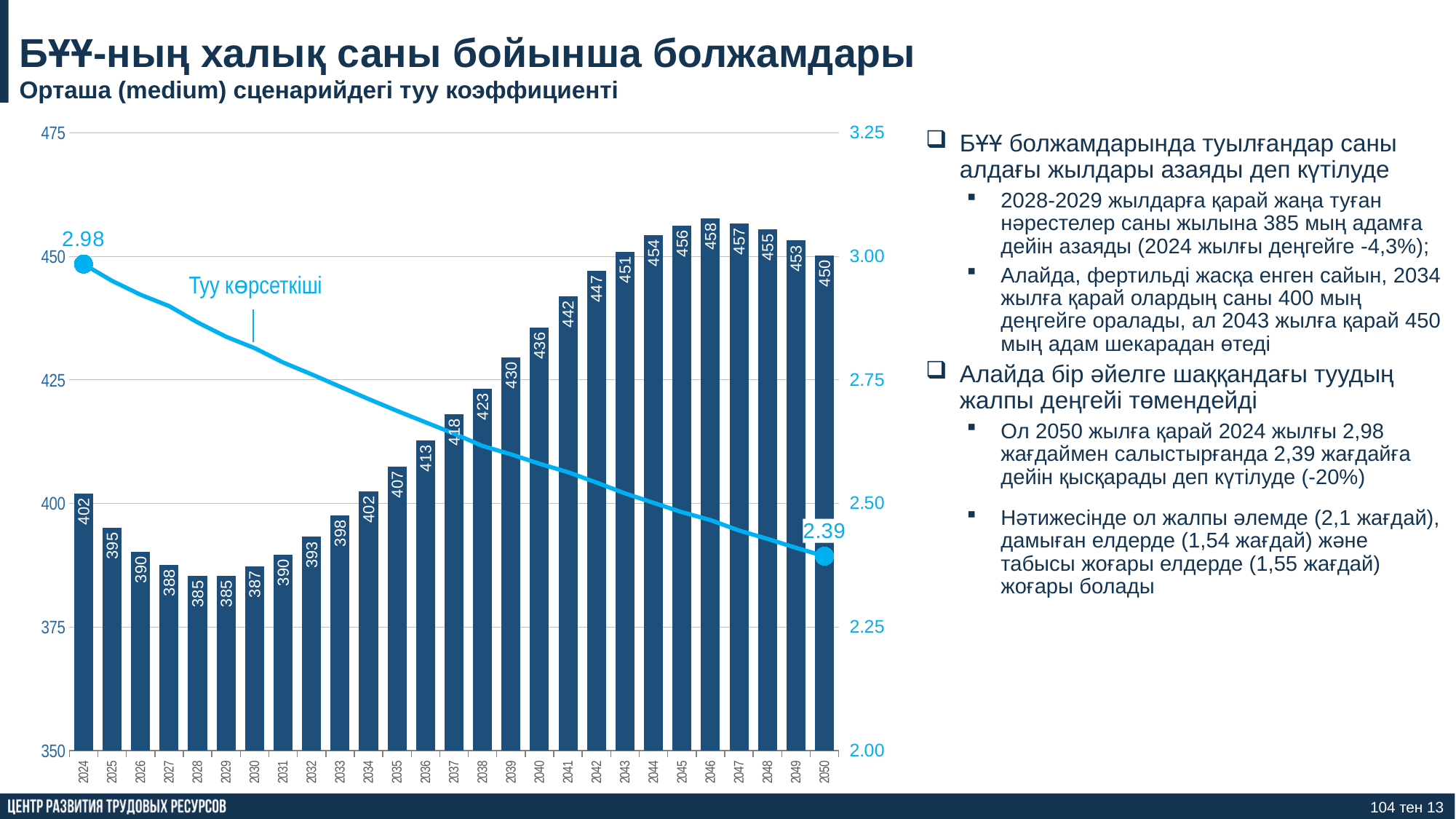
Which bar is taller, 2035 or 2040? 2040 Does the line rise or fall from 2024 to 2050? falls Which year has the highest bar? 2046 What is the label attached to the line on the chart? Туу көрсеткіші What is the value of the bar for 2046? 458 What is the value of the bar for 2024? 402 What is the difference between the bar values for 2046 and 2024? 56 What value does the line show for 2050? 2.39 How many years (bars) are shown on the chart? 27 What value does the line show for 2024? 2.98 What is the lowest bar value shown on the chart? 385 What is the value of the bar for 2050? 450